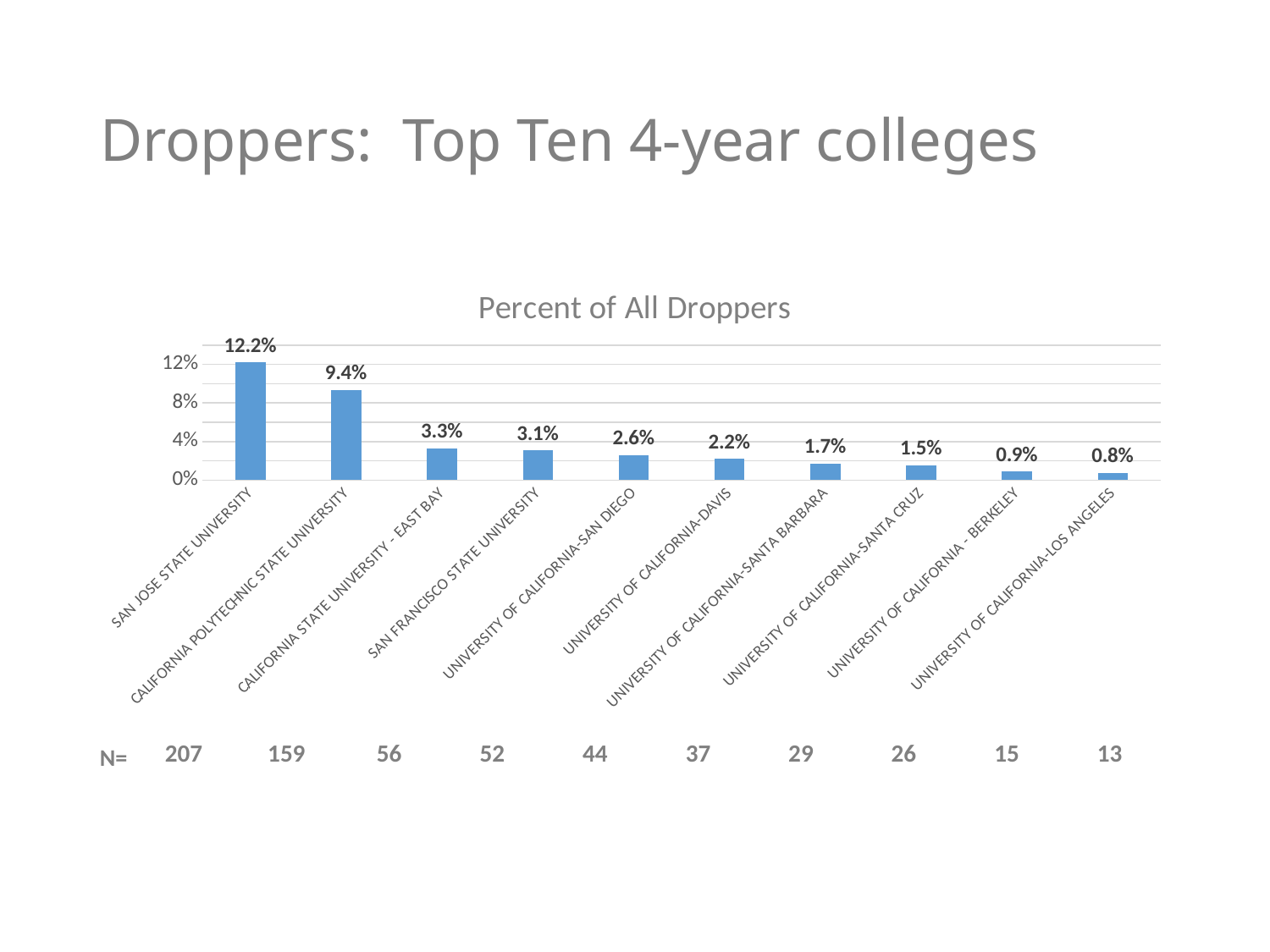
Is the value for California Polytechnic State University greater or less than 8%? greater What is the value for University of California-Davis? 2.2% What is the value for University of California-Santa Cruz? 1.5% What kind of chart is shown on the slide? bar chart What is the title of the chart? Percent of All Droppers How many colleges are shown in the chart? 10 What is the difference between the values for San Jose State University and California Polytechnic State University? 2.8% Which is larger, the value for California State University - East Bay or the value for University of California-San Diego? California State University - East Bay Which college has the highest percent of all droppers? San Jose State University Which college has the lowest percent of all droppers? University of California-Los Angeles What is the value for San Jose State University? 12.2% Do the values rise or fall from left to right along the x axis? fall